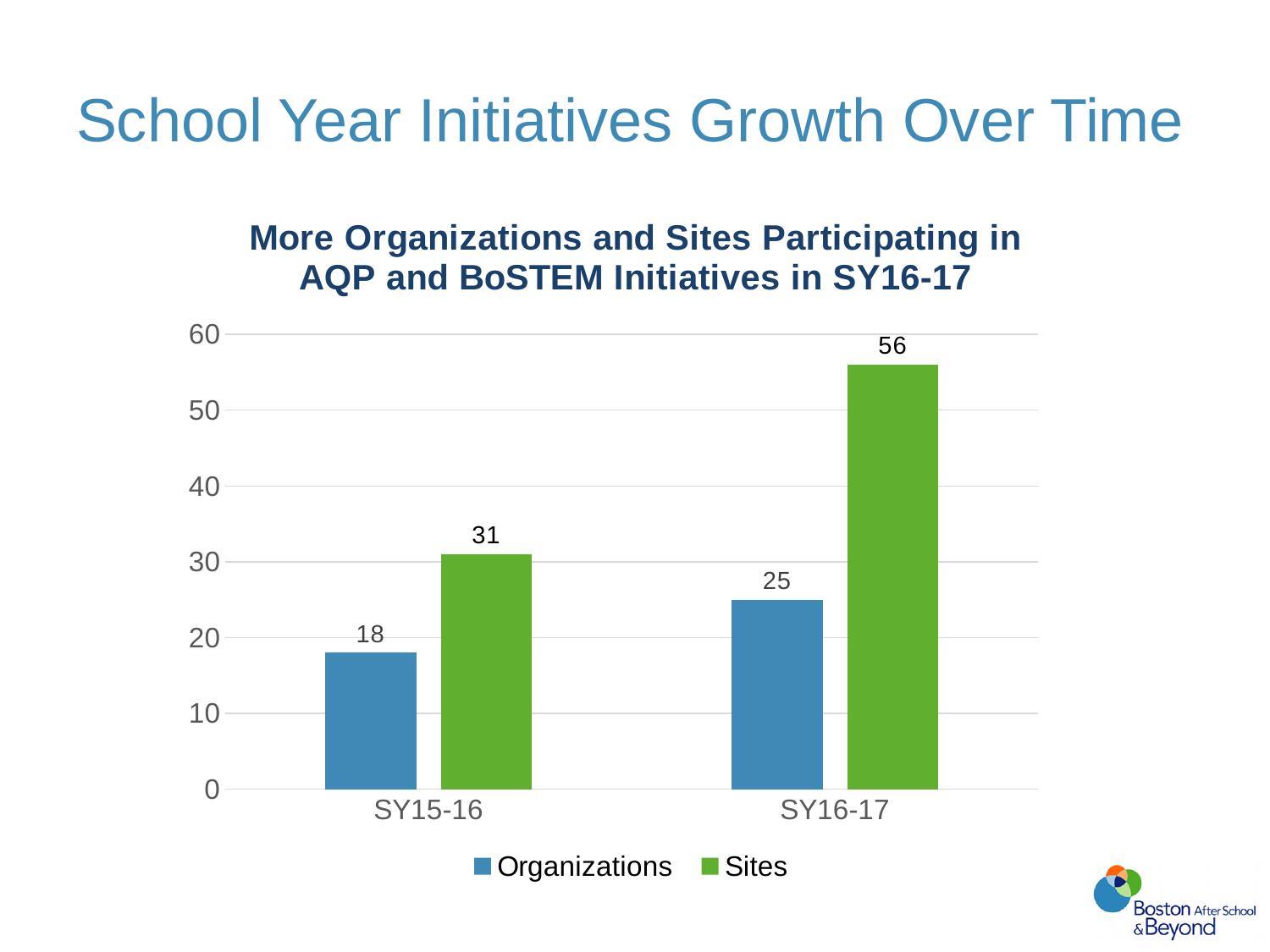
Which bar has the highest value on the chart? Sites in SY16-17 What is the value for Sites in SY15-16? 31 What is the value for Organizations in SY15-16? 18 What is the value for Organizations in SY16-17? 25 What is the difference between the Organizations values for SY16-17 and SY15-16? 7 What is the difference between the Sites values for SY16-17 and SY15-16? 25 Which bar has the lowest value on the chart? Organizations in SY15-16 Which is larger in SY16-17, Organizations or Sites? Sites How many series does the legend list? 2 Do the Sites values rise or fall from SY15-16 to SY16-17? Rise What is the value for Sites in SY16-17? 56 What kind of chart is shown on the slide? Bar chart